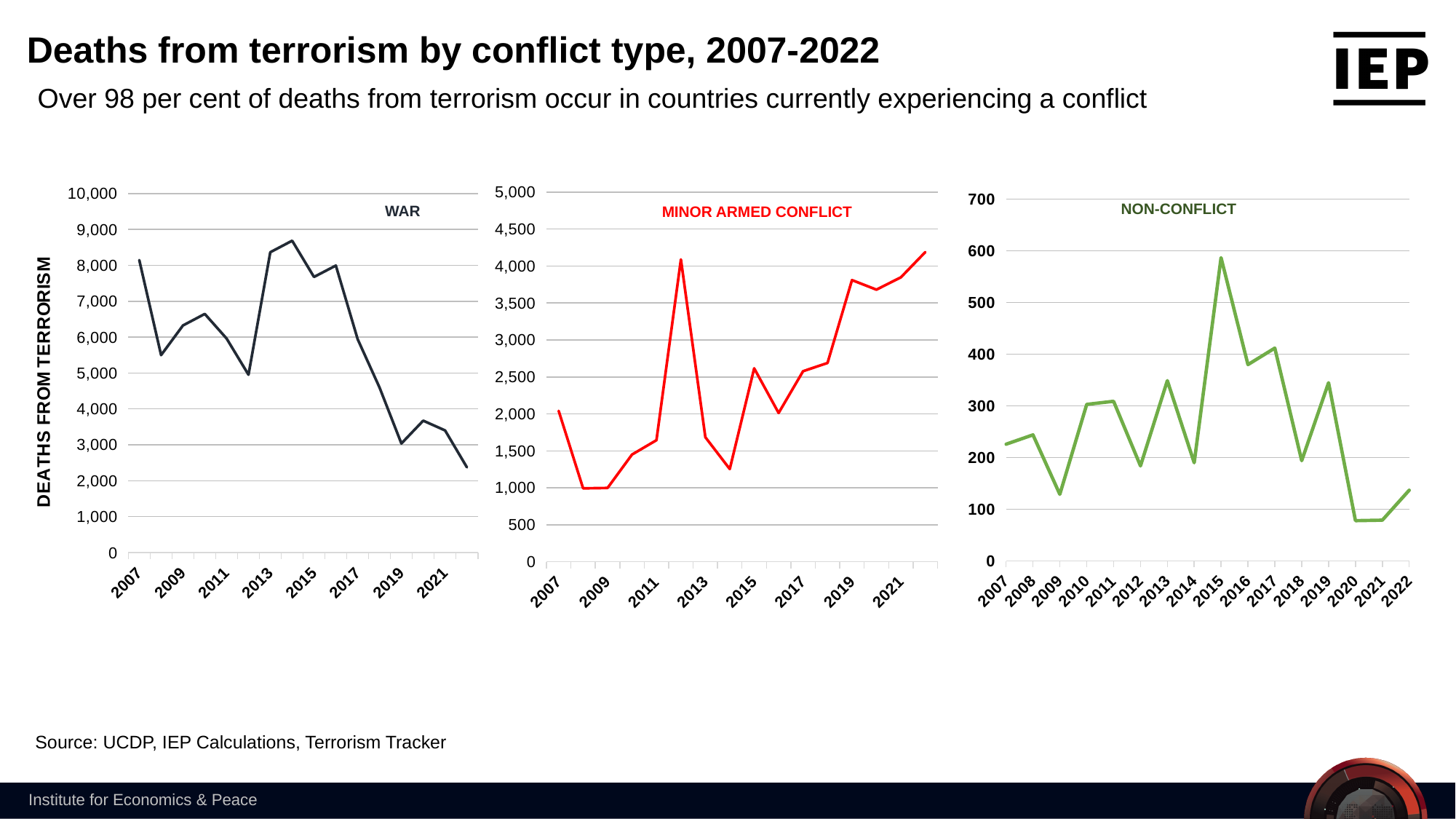
In the NON-CONFLICT chart, how many years are plotted along the x axis? 16 In the WAR chart, which year has the highest number of deaths from terrorism? 2014 In the WAR chart, is the value for 2013 greater or less than 8,000? greater In the WAR chart, is the value for 2019 greater or less than 4,000? less What kind of chart is the WAR chart? line chart In the WAR chart, which year has more deaths from terrorism, 2007 or 2022? 2007 In the WAR chart, which year has the lowest number of deaths from terrorism? 2022 In the MINOR ARMED CONFLICT chart, is the value for 2012 greater or less than 3,500? greater In the NON-CONFLICT chart, which year has the highest number of deaths from terrorism? 2015 In the WAR chart, do deaths from terrorism rise or fall from 2016 to 2019? fall